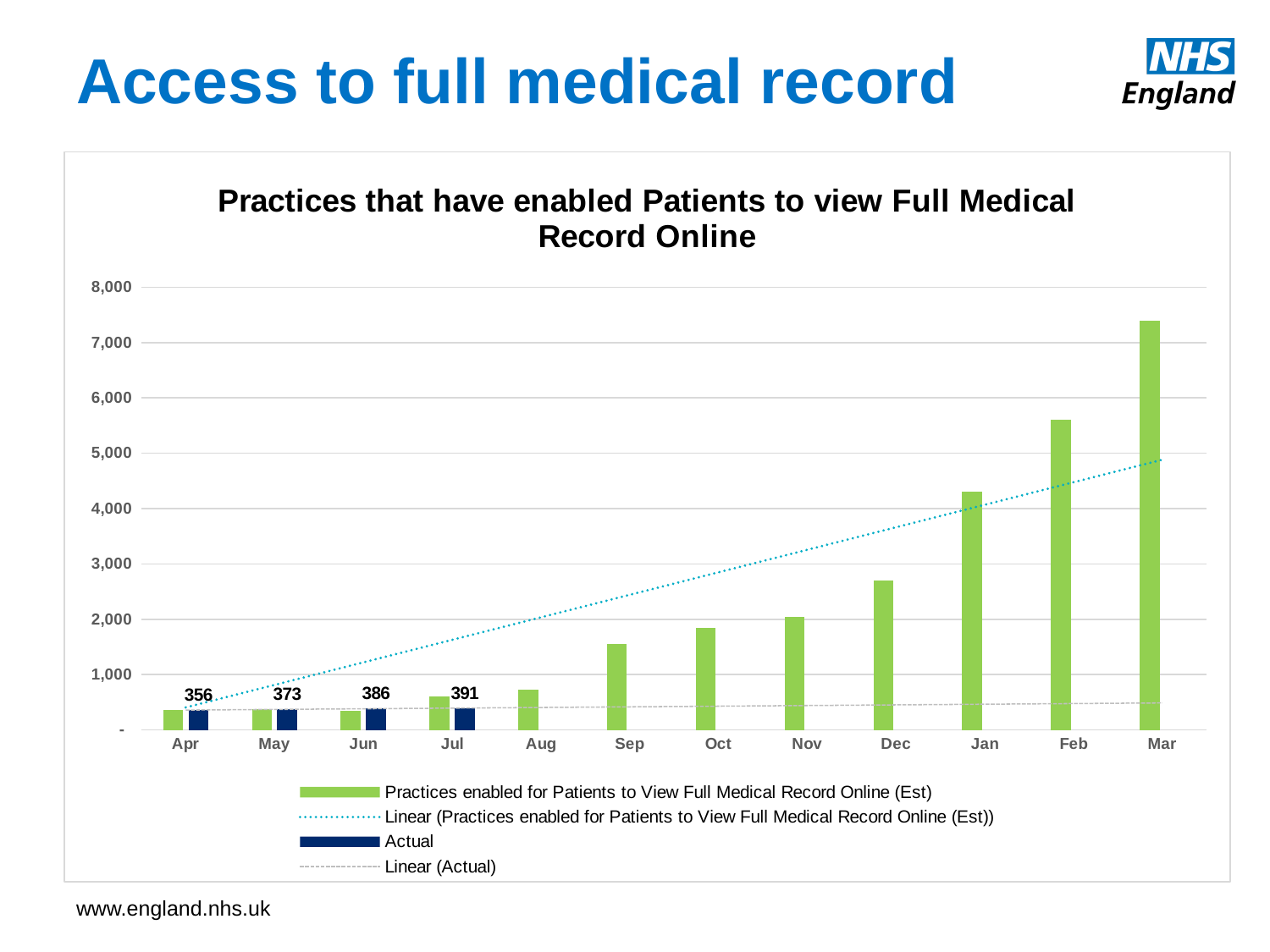
Do the estimated (green) bars rise or fall from Apr to Mar? Rise What is the Actual value for Jun? 386 What is the Actual value for Jul? 391 Which month has the lowest Actual value? Apr Is the estimated value (green bar) for Sep greater or less than 2,000? less Is the estimated value (green bar) for Mar greater or less than 7,000? greater Which month has the highest Actual value? Jul How many months are shown on the x axis? 12 What is the difference between the Actual values for Jul and Apr? 35 How many entries does the legend list? 4 What is the Actual value for Apr? 356 What kind of chart is this? Bar chart